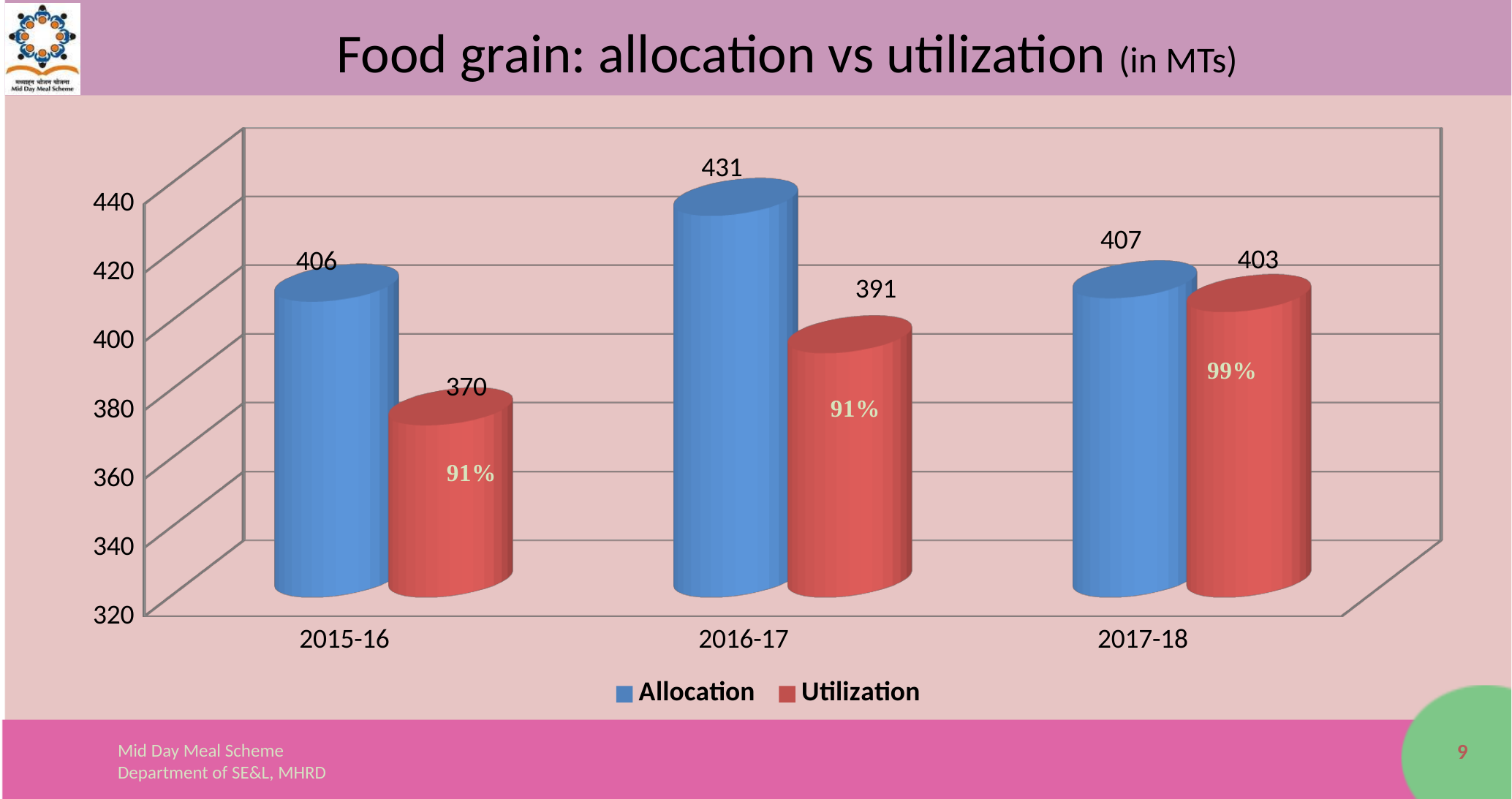
Which year has the lowest Utilization? 2015-16 What is the Allocation value for 2016-17? 431 What is the difference between Allocation and Utilization in 2016-17? 40 Which is larger in 2017-18, Allocation or Utilization? Allocation What is the Utilization value for 2017-18? 403 How many years are shown on the x axis? 3 How many series does the legend list? 2 What utilization percentage is printed on the Utilization bar for 2017-18? 99% What is the difference between Allocation and Utilization in 2015-16? 36 Which year has the highest Allocation? 2016-17 What is the Utilization value for 2015-16? 370 What kind of chart is shown on the slide? Bar chart